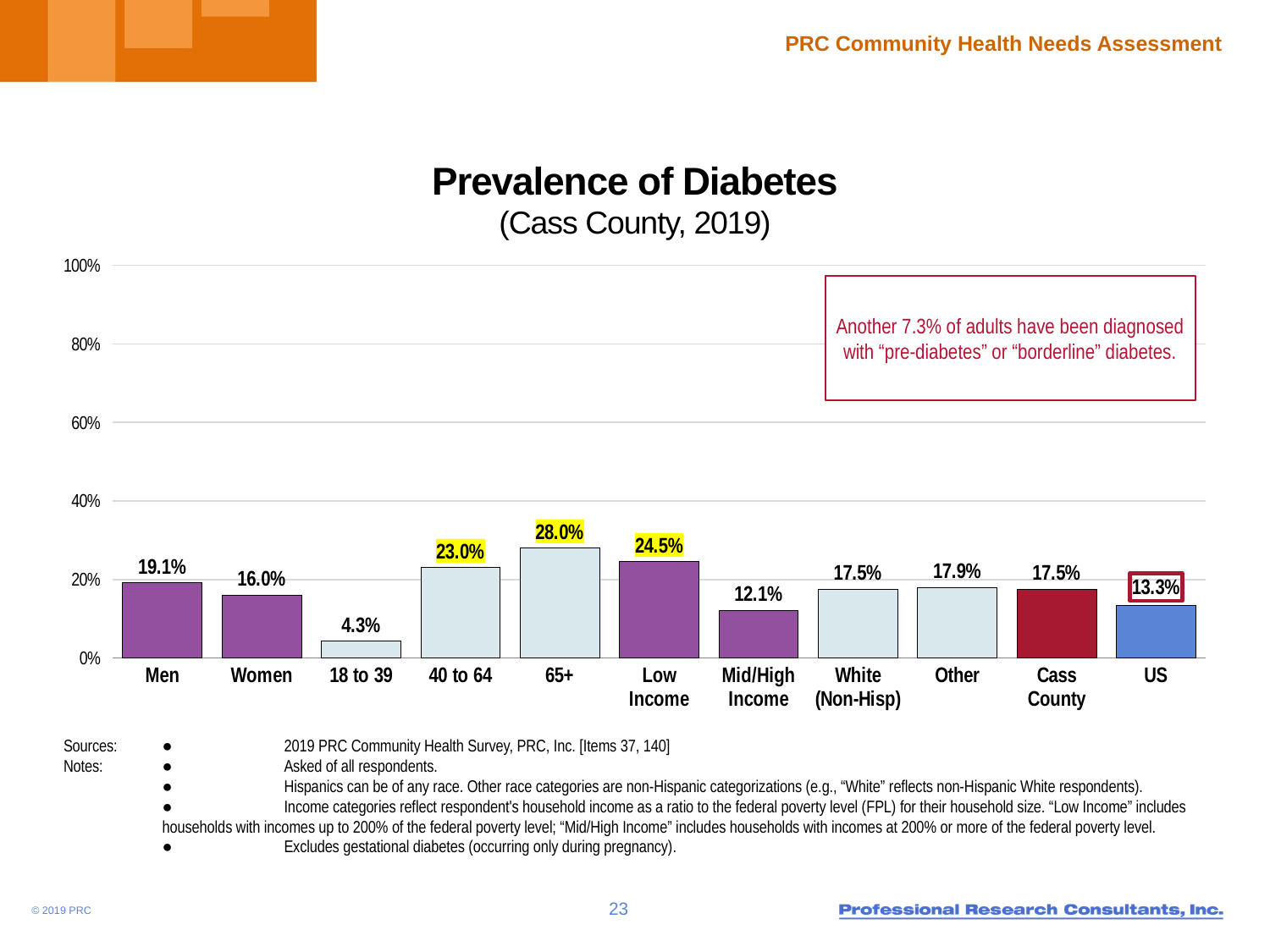
Which is larger, the value for Men or the value for Women? Men What is the difference between the Low Income and Mid/High Income values? 12.4% How many categories are shown on the x axis? 11 Which category has the highest prevalence of diabetes? 65+ What is the value shown for the 65+ age group? 28.0% What is the title of the chart? Prevalence of Diabetes (Cass County, 2019) What is the prevalence of diabetes for Men? 19.1% What is the value shown for Cass County? 17.5% Is the value for 40 to 64 greater or less than 20%? greater Which category has the lowest prevalence of diabetes? 18 to 39 What is the value shown for the US? 13.3% What kind of chart is shown on the slide? Bar chart